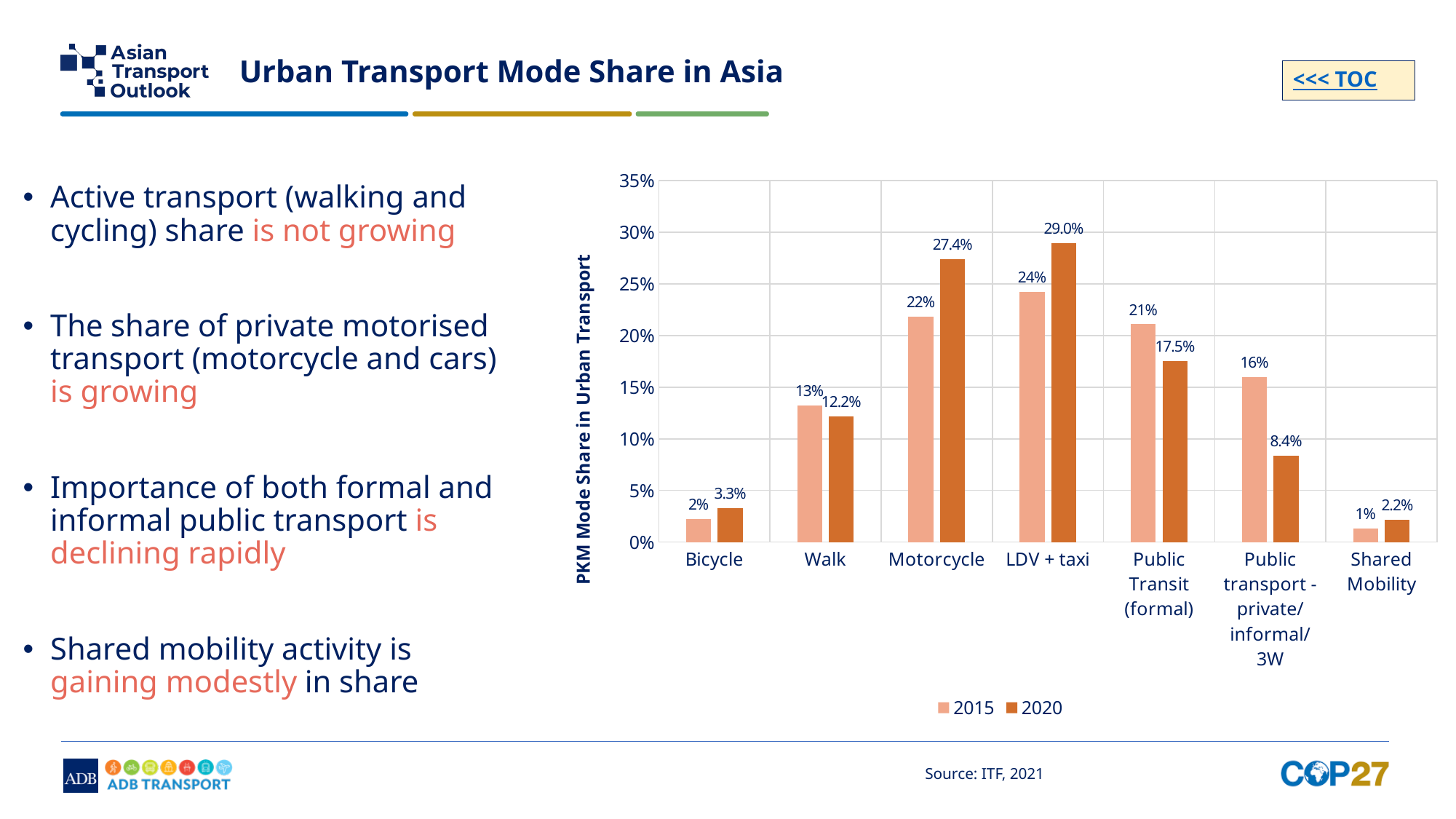
What kind of chart is shown on the slide? Bar chart Which category has the lowest 2015 value? Shared Mobility What is the 2020 value for Public transport - private/informal/3W? 8.4% How many series does the legend list? 2 Which is larger for Public Transit (formal): the 2015 value or the 2020 value? 2015 What is the 2015 value for Public Transit (formal)? 21% Which category has the highest 2020 value? LDV + taxi What is the difference between the 2020 values for LDV + taxi and Motorcycle? 1.6 percentage points How many categories are shown on the x axis? 7 Is the 2020 value for Motorcycle greater or less than 25%? greater What is the 2020 value for LDV + taxi? 29.0% What is the 2015 value for Walk? 13%